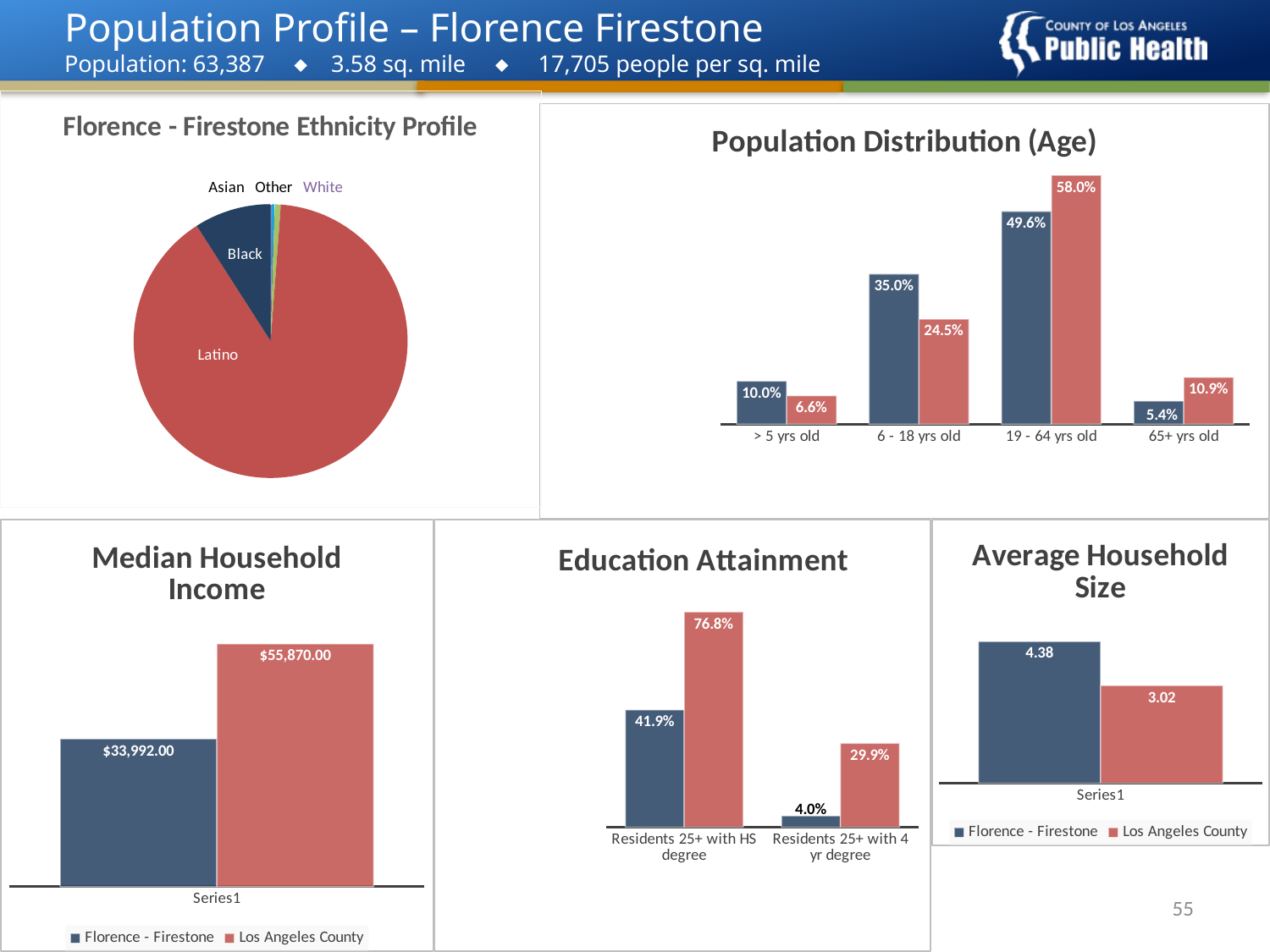
In the Average Household Size chart, what is the value for Florence - Firestone? 4.38 In the Florence - Firestone Ethnicity Profile pie chart, which ethnicity has the largest slice? Latino In the Population Distribution (Age) chart, how many age categories are shown on the x axis? 4 In the Population Distribution (Age) chart, which age category has the highest red bar? 19 - 64 yrs old In the Average Household Size chart, which is larger, Florence - Firestone or Los Angeles County? Florence - Firestone In the Population Distribution (Age) chart, what is the value of the blue bar for 6 - 18 yrs old? 35.0% In the Education Attainment chart, what is the difference between the Los Angeles County and Florence - Firestone values for Residents 25+ with HS degree? 34.9% In the Median Household Income chart, what is the value for Los Angeles County? $55,870.00 In the Education Attainment chart, what is the Florence - Firestone value for Residents 25+ with 4 yr degree? 4.0% In the Education Attainment chart, what is the Los Angeles County value for Residents 25+ with HS degree? 76.8% In the Median Household Income chart, what is the value for Florence - Firestone? $33,992.00 In the Median Household Income chart, what is the difference between the Los Angeles County and Florence - Firestone values? $21,878.00